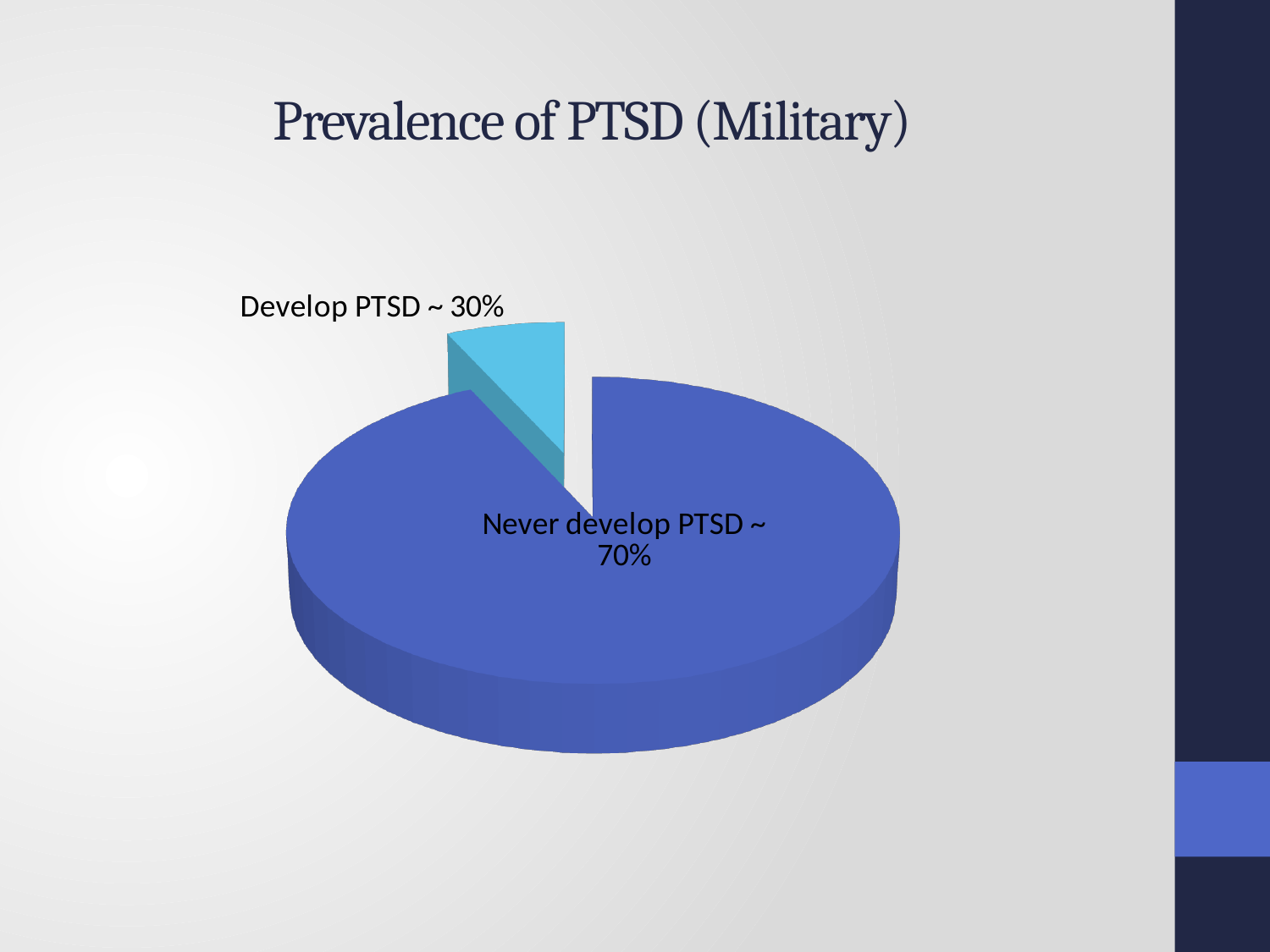
What is the title of the chart? Prevalence of PTSD (Military) What share of the pie is labelled "Never develop PTSD"? 70% By how many percentage points does the "Never develop PTSD" share exceed the "Develop PTSD" share? 40 How many slices does the pie chart have? 2 What share of the pie is labelled "Develop PTSD"? 30% Which slice of the pie is the smallest? Develop PTSD Which is larger, the "Develop PTSD" slice or the "Never develop PTSD" slice? Never develop PTSD Is the share for "Develop PTSD" greater or less than 50%? less What colour is the "Develop PTSD" slice? light blue Which slice of the pie is the largest? Never develop PTSD What kind of chart is shown on the slide? pie chart